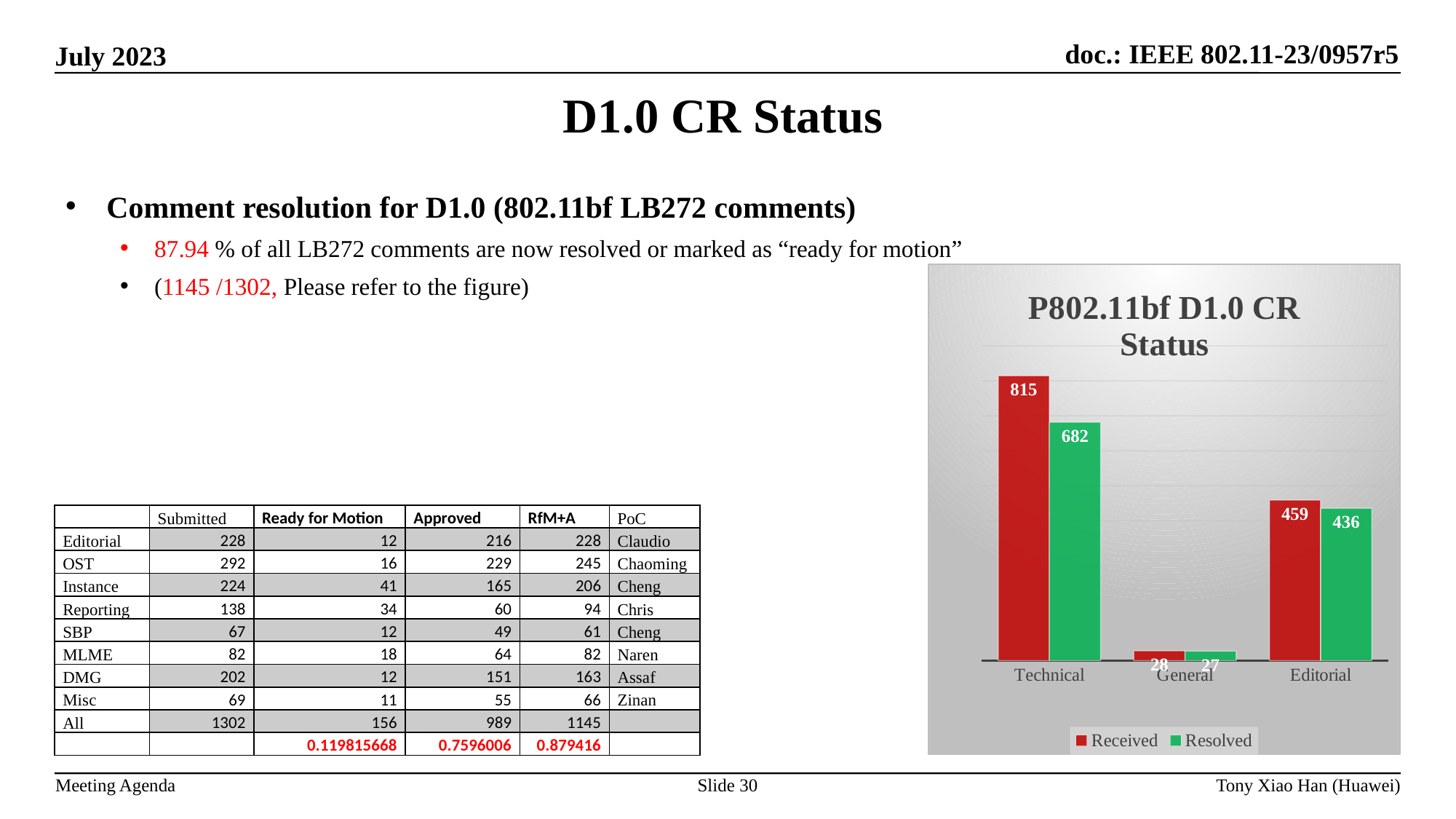
What is the difference between Received and Resolved for Editorial in the P802.11bf D1.0 CR Status chart? 23 What is the Received value for General in the P802.11bf D1.0 CR Status chart? 28 How many series does the legend of the P802.11bf D1.0 CR Status chart list? 2 What is the Resolved value for Editorial in the P802.11bf D1.0 CR Status chart? 436 What is the Resolved value for Technical in the P802.11bf D1.0 CR Status chart? 682 In the P802.11bf D1.0 CR Status chart, is the Received value for Technical or the Received value for Editorial larger? Technical Which category has the lowest Resolved value in the P802.11bf D1.0 CR Status chart? General Which category has the highest Received value in the P802.11bf D1.0 CR Status chart? Technical What is the difference between Received and Resolved for Technical in the P802.11bf D1.0 CR Status chart? 133 How many categories are shown on the x axis of the P802.11bf D1.0 CR Status chart? 3 What is the Received value for Technical in the P802.11bf D1.0 CR Status chart? 815 What type of chart is the P802.11bf D1.0 CR Status chart? Bar chart